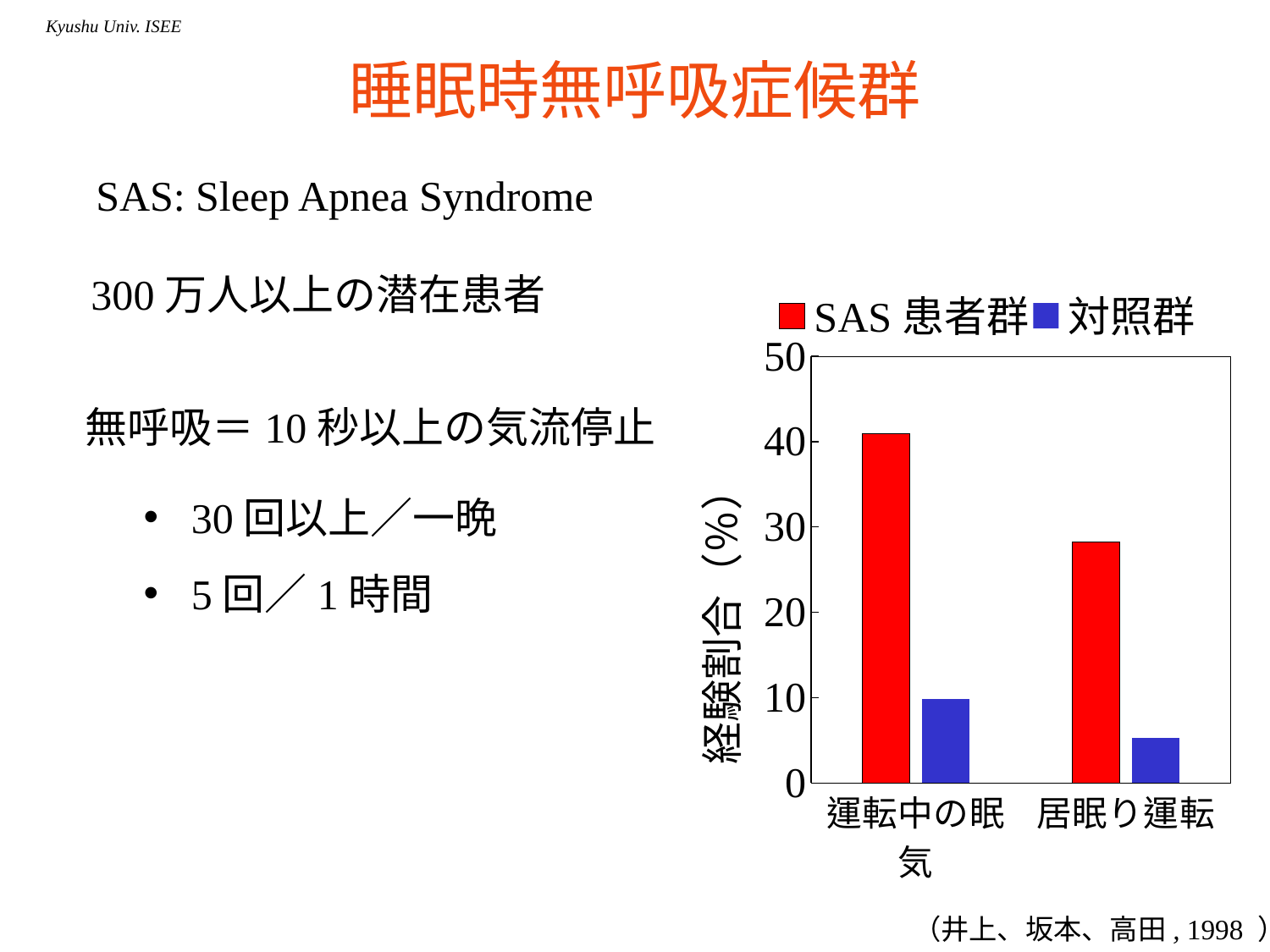
Which bar is the highest in the chart? SAS 患者群 for 運転中の眠気 Is the value for SAS 患者群 in 居眠り運転 greater or less than 20? greater For 居眠り運転, which group has the larger value, SAS 患者群 or 対照群? SAS 患者群 Is the value for 対照群 in 運転中の眠気 greater or less than 20? less For 運転中の眠気, which group has the larger value, SAS 患者群 or 対照群? SAS 患者群 What kind of chart is shown on the slide? bar chart How many categories are shown on the x axis of the chart? 2 Is the value for SAS 患者群 in 運転中の眠気 greater or less than 30? greater How many series does the chart legend list? 2 Which series is shown in red in the chart? SAS 患者群 What is the label of the y axis of the chart? 経験割合 (%) Which bar is the lowest in the chart? 対照群 for 居眠り運転